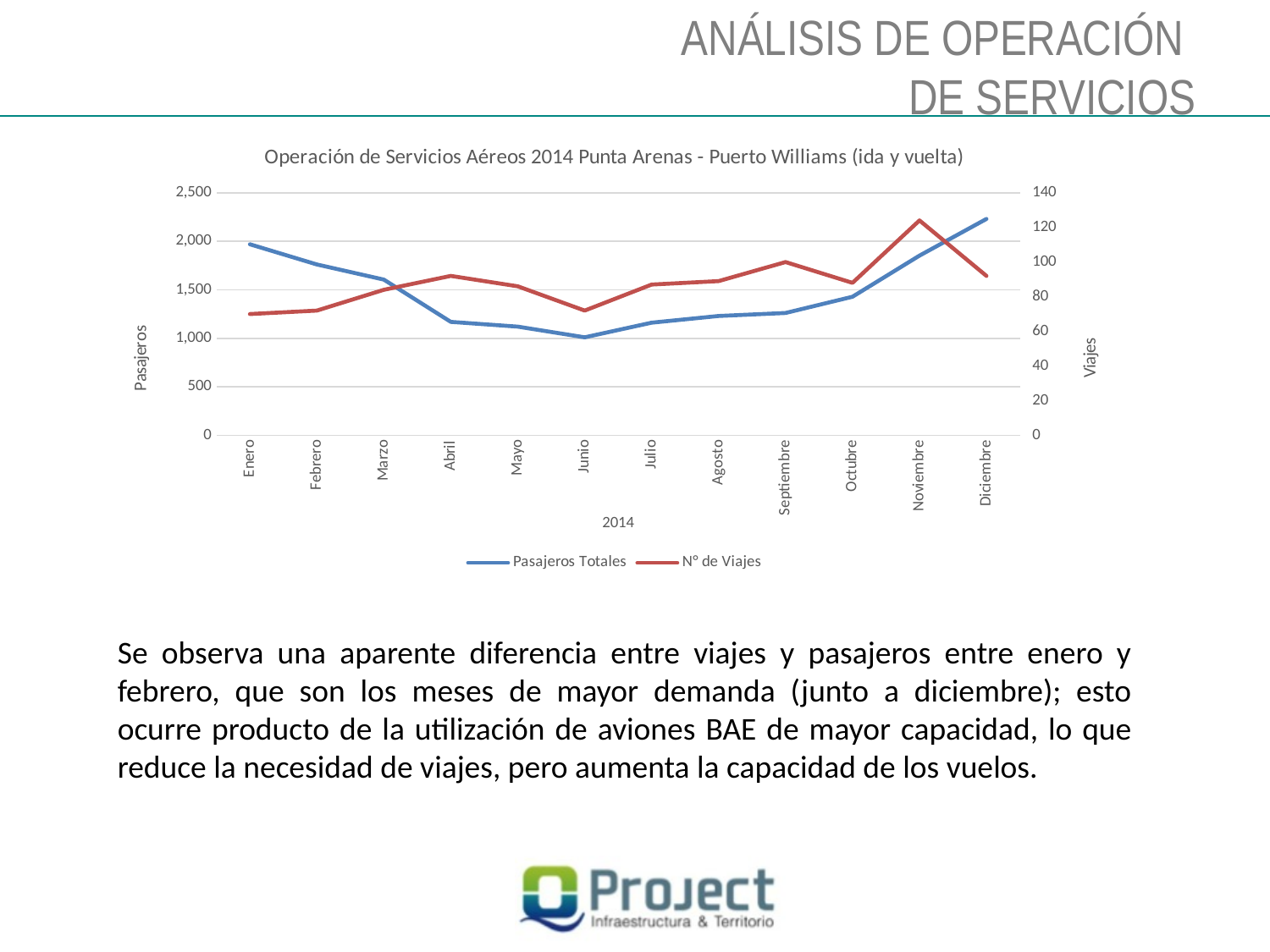
Is the value of N° de Viajes for Noviembre greater or less than 100? greater Is the value of Pasajeros Totales for Enero greater or less than 1,500? greater In which month is the Pasajeros Totales series at its highest? Diciembre How many series does the chart legend list? 2 Does the Pasajeros Totales series rise or fall from Enero to Junio? fall What is the title of the chart? Operación de Servicios Aéreos 2014 Punta Arenas - Puerto Williams (ida y vuelta) Which month has more Pasajeros Totales, Enero or Abril? Enero How many months are plotted along the x axis of the chart? 12 Is the value of Pasajeros Totales for Junio greater or less than 1,500? less In which month is the Pasajeros Totales series at its lowest? Junio In which month is the N° de Viajes series at its highest? Noviembre What kind of chart is shown on the slide? line chart